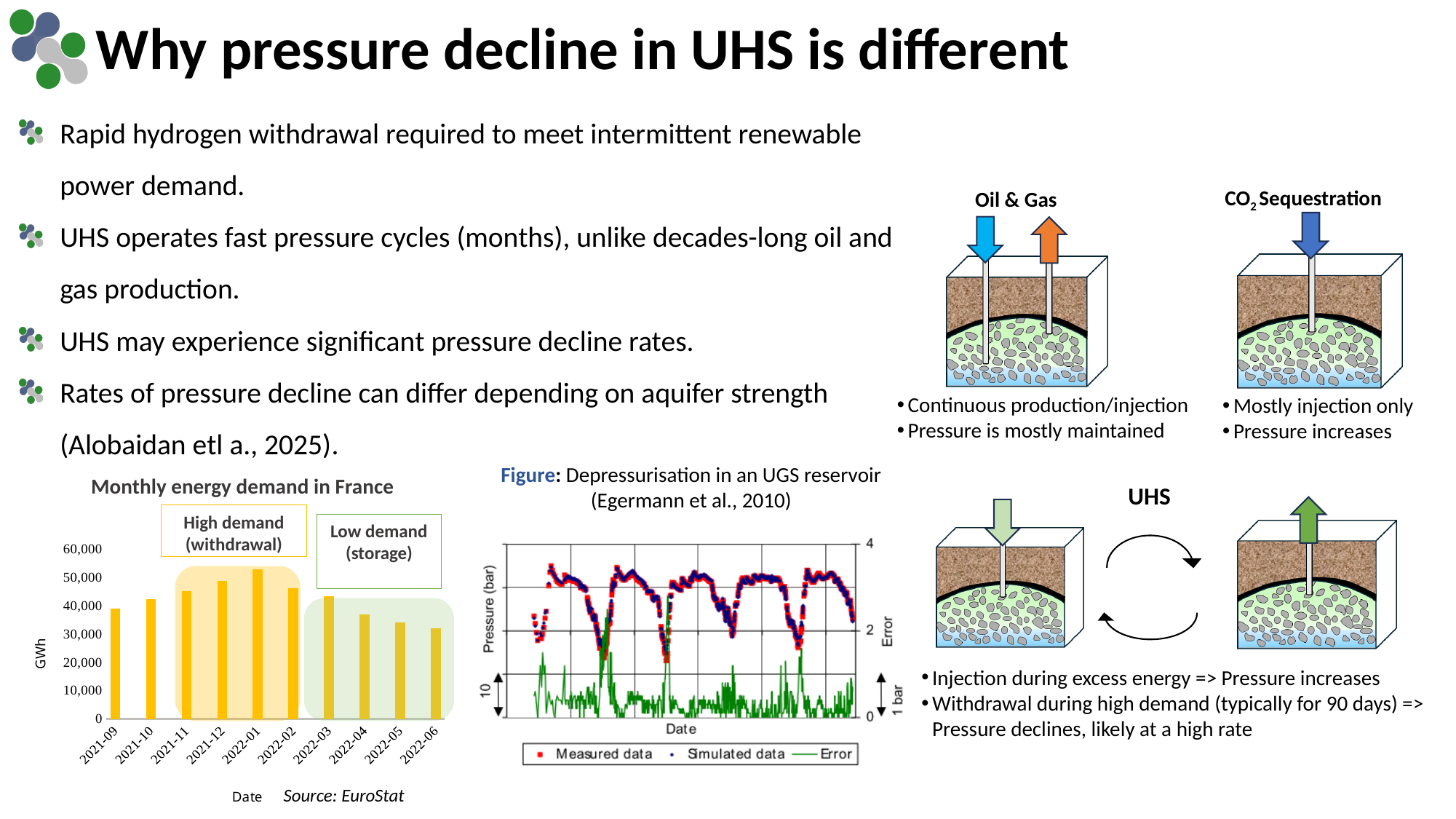
In the 'Monthly energy demand in France' chart, do the values rise or fall from 2022-01 to 2022-06? fall In the 'Monthly energy demand in France' chart, how many months (bars) are shown? 10 What unit is shown on the y axis of the 'Monthly energy demand in France' chart? GWh In the 'Monthly energy demand in France' chart, is the value for 2021-12 greater or less than 40,000? greater In the 'Monthly energy demand in France' chart, which month has the lowest energy demand? 2022-06 What kind of chart is the 'Monthly energy demand in France' chart? bar chart In the 'Monthly energy demand in France' chart, which month has the larger energy demand, 2021-12 or 2022-04? 2021-12 In the 'Depressurisation in an UGS reservoir' line chart, how many series does the legend list? 3 In the 'Monthly energy demand in France' chart, is the value for 2022-01 greater or less than 50,000? greater In the 'Monthly energy demand in France' chart, which month has the highest energy demand? 2022-01 In the 'Monthly energy demand in France' chart, is the value for 2022-04 greater or less than 40,000? less